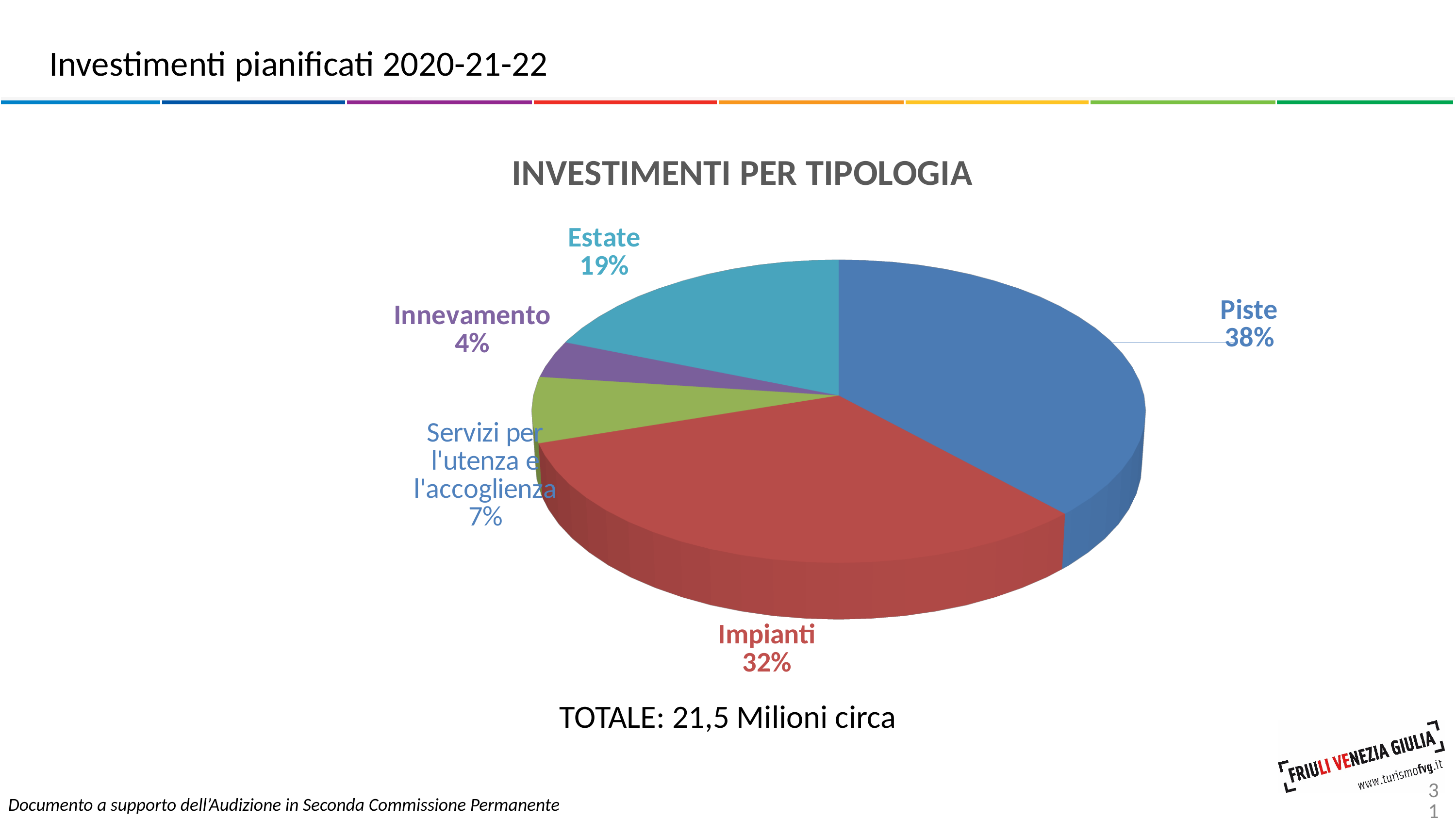
What share of the pie does Estate represent? 19% What share of the pie does Impianti represent? 32% What share of the pie does Piste represent? 38% Which is larger, the share for Estate or the share for Servizi per l'utenza e l'accoglienza? Estate Which category has the largest slice of the pie? Piste How many categories are shown in the pie chart? 5 What is the title of the chart? INVESTIMENTI PER TIPOLOGIA What is the difference in percentage points between Piste and Impianti? 6 What kind of chart is shown on the slide? Pie chart Which category has the smallest slice of the pie? Innevamento